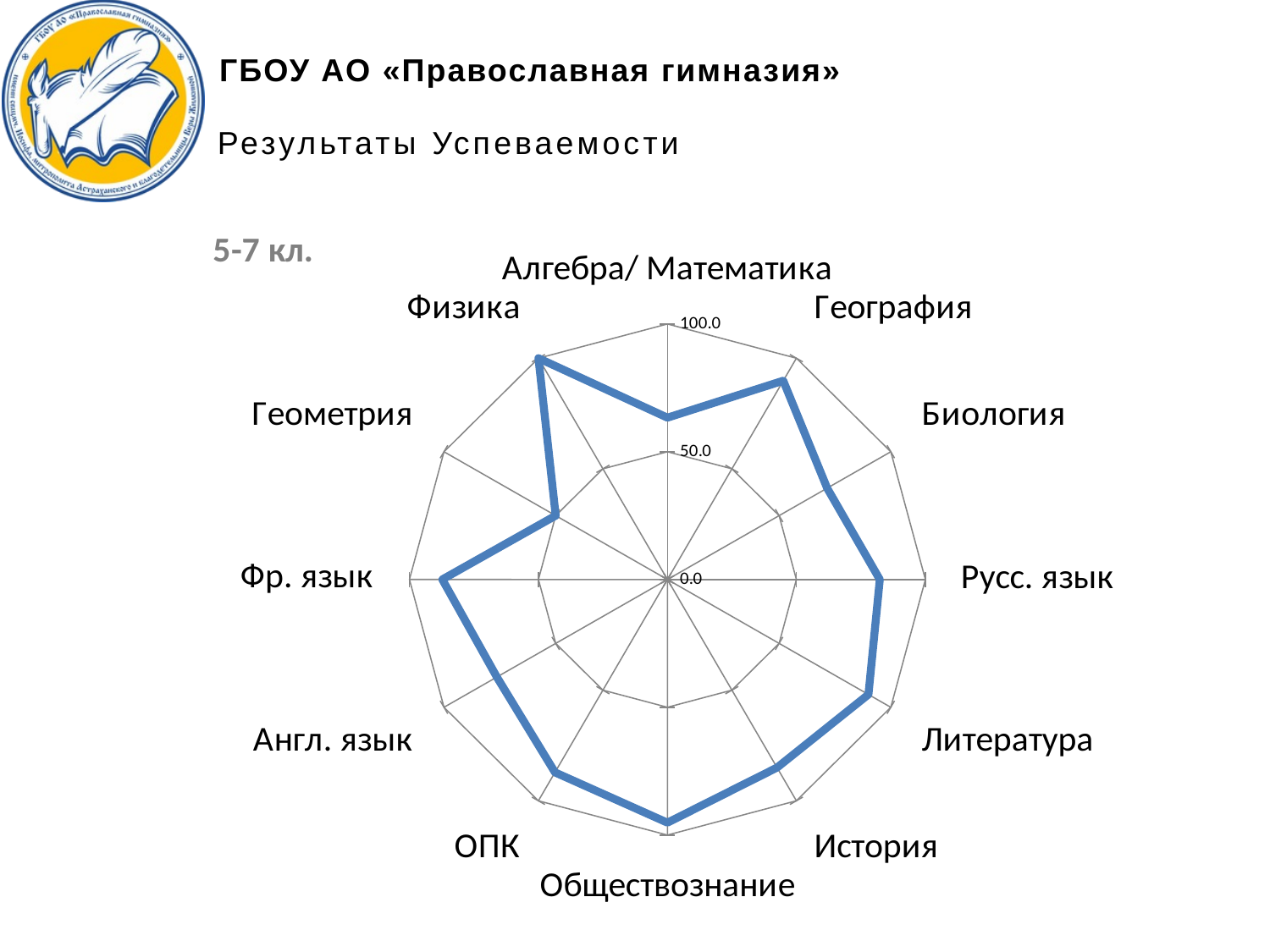
Which has the larger value, Геометрия or Физика? Физика What is the maximum value shown on the radar chart's axis scale? 100.0 What kind of chart is shown on the slide? Radar chart Which subject has the lowest value on the radar chart? Геометрия Is the value for Алгебра/ Математика greater or less than 50.0? greater Which has the larger value, Геометрия or Фр. язык? Фр. язык Is the value for Физика greater or less than 50.0? greater How many subject categories are plotted on the radar chart? 12 Is the value for Обществознание greater or less than 50.0? greater Which class group does the chart refer to, according to the label next to it? 5-7 кл. Which has the larger value, Алгебра/ Математика or География? География